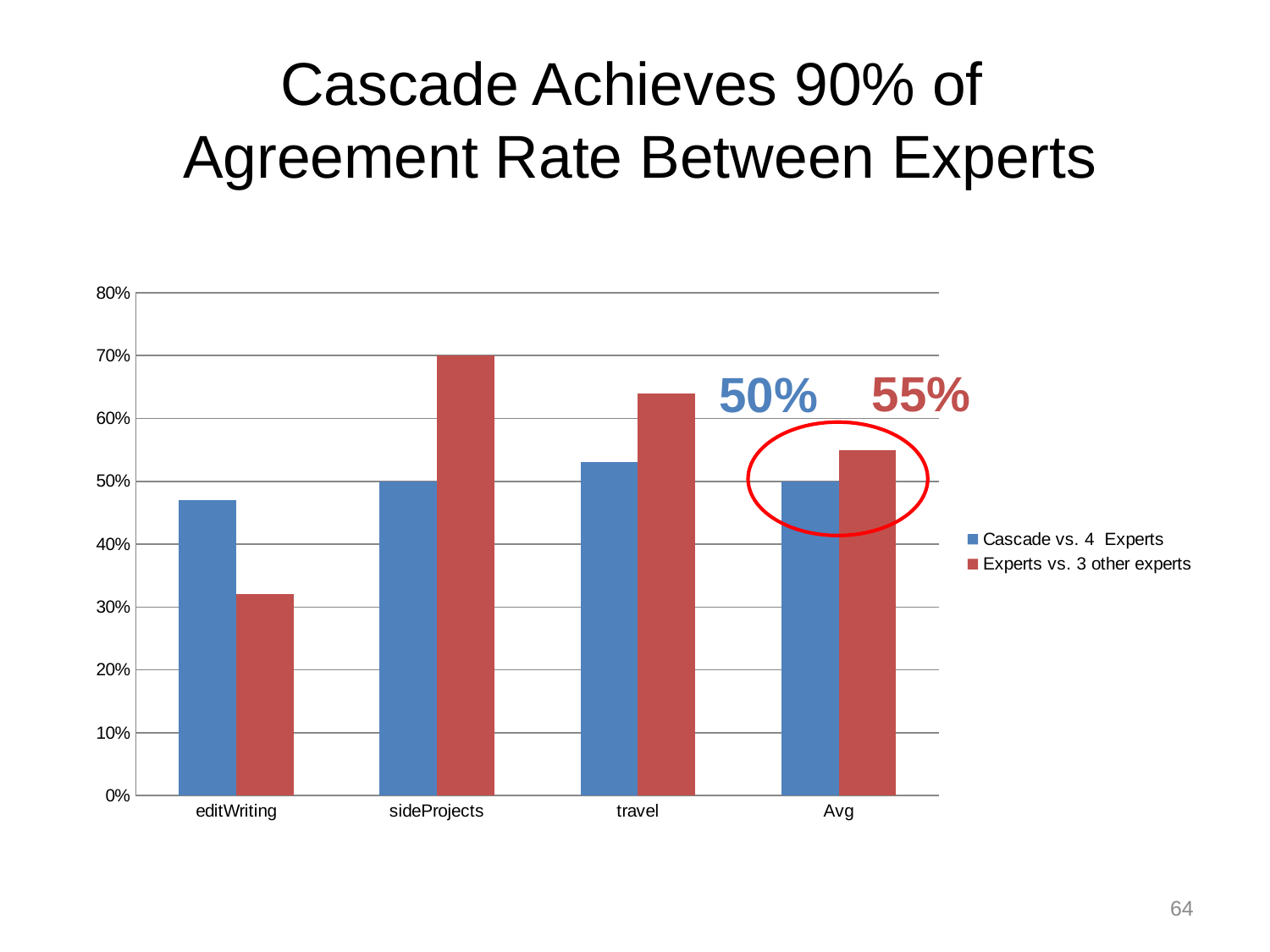
Is the Experts vs. 3 other experts value for editWriting greater or less than 40%? less What is the value for Avg in the Cascade vs. 4 Experts series? 50% What kind of chart is shown on the slide? bar chart How many categories are shown on the x axis? 4 Which category has the lowest value in the Experts vs. 3 other experts series? editWriting For editWriting, which series has the larger value? Cascade vs. 4 Experts What is the value for sideProjects in the Experts vs. 3 other experts series? 70% How many series does the legend list? 2 For Avg, what is the difference between the Experts vs. 3 other experts value and the Cascade vs. 4 Experts value? 5% Is the Experts vs. 3 other experts value for travel greater or less than 60%? greater Which category has the highest value in the Experts vs. 3 other experts series? sideProjects What is the value for Avg in the Experts vs. 3 other experts series? 55%